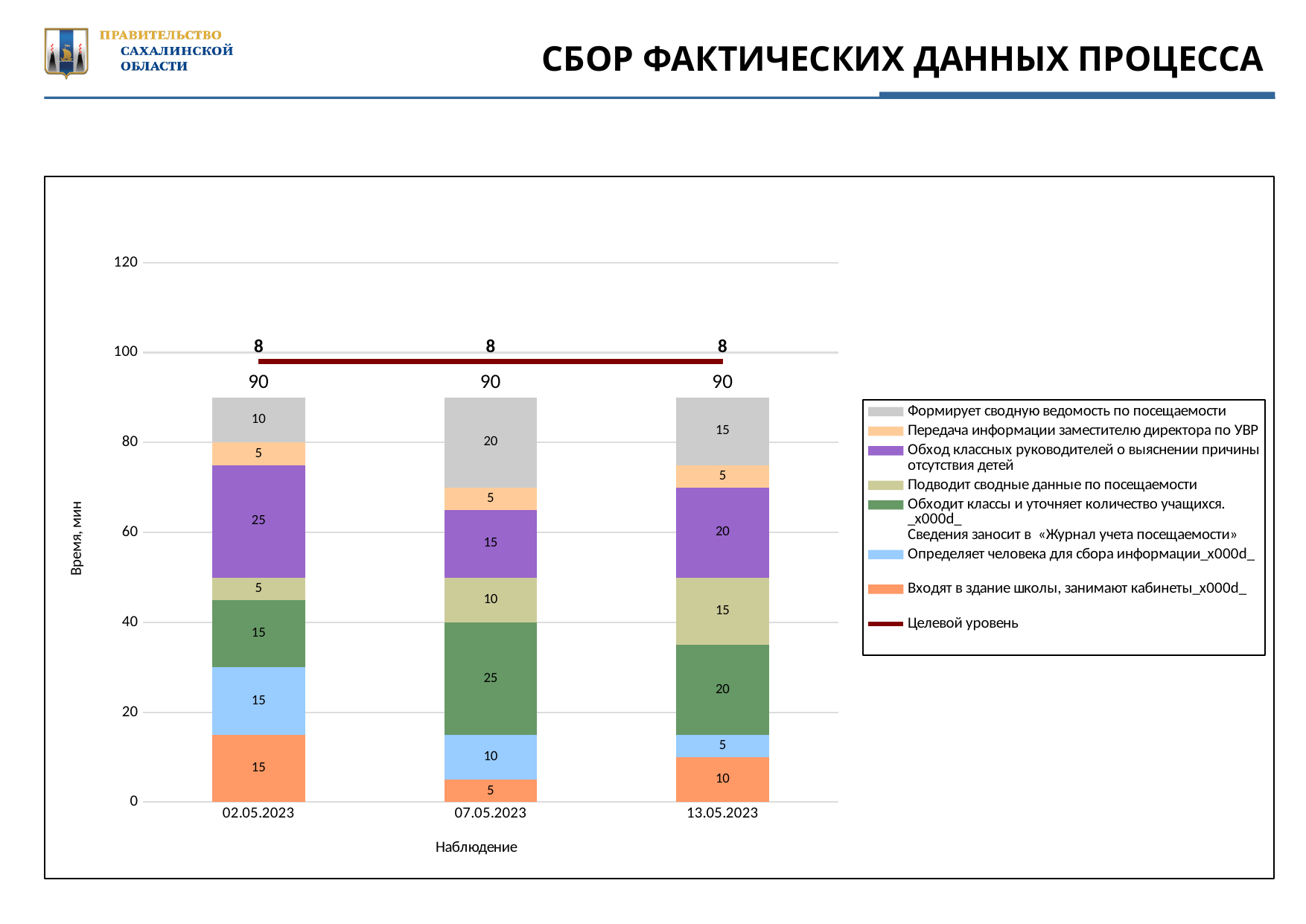
What is the value of the segment 'Обход классных руководителей о выяснении причины отсутствия детей' for 02.05.2023? 25 What is the difference between the 'Формирует сводную ведомость по посещаемости' segment on 07.05.2023 and on 02.05.2023? 10 What is the value of the segment 'Формирует сводную ведомость по посещаемости' for 07.05.2023? 20 What is the value of the segment 'Подводит сводные данные по посещаемости' for 13.05.2023? 15 What is the label of the y axis? Время, мин Which is larger: the 'Входят в здание школы, занимают кабинеты' segment on 02.05.2023 or on 07.05.2023? 02.05.2023 How many observation dates are shown on the x axis? 3 What is the total of the stacked bar for 07.05.2023? 90 On which date is the segment 'Обходит классы и уточняет количество учащихся' the largest? 07.05.2023 What is the value of the segment 'Входят в здание школы, занимают кабинеты' for 02.05.2023? 15 What type of chart is shown on the slide? stacked bar chart with a target line (combination bar and line chart) On which date is the segment 'Определяет человека для сбора информации' the smallest? 13.05.2023